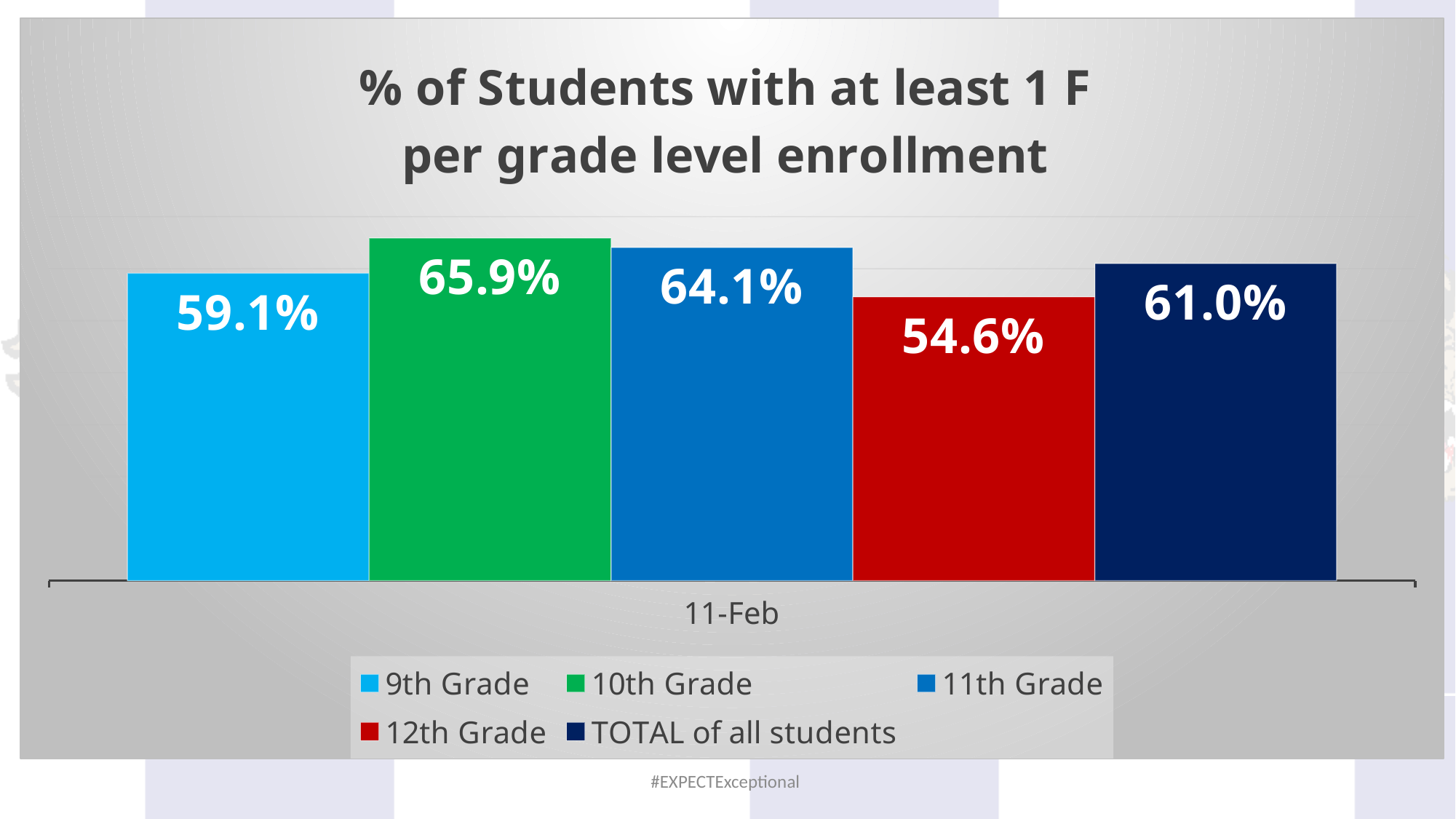
What is the title of the chart? % of Students with at least 1 F per grade level enrollment Which series has the highest value? 10th Grade What is the value for 9th Grade? 59.1% What is the difference between the 10th Grade and 12th Grade values? 11.3% What is the value for 10th Grade? 65.9% What is the value for 12th Grade? 54.6% Which series has the lowest value? 12th Grade Which is larger, the value for 9th Grade or the value for 11th Grade? 11th Grade What kind of chart is shown? Bar chart What is the value for 11th Grade? 64.1% How many series does the legend list? 5 What is the value for TOTAL of all students? 61.0%